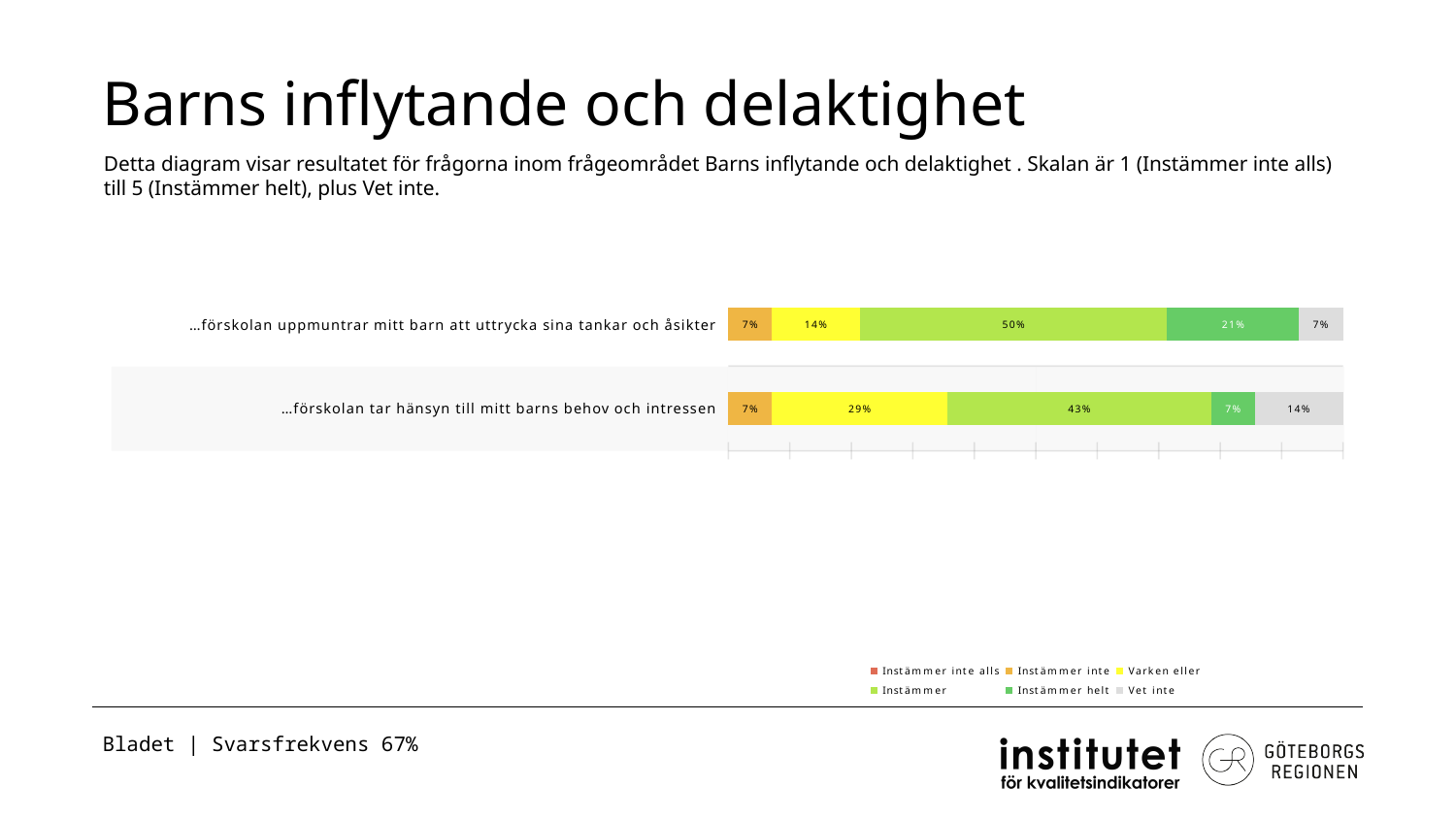
What is the difference between the 'Varken eller' shares of the two statements? 15% What is the 'Instämmer helt' share for '…förskolan uppmuntrar mitt barn att uttrycka sina tankar och åsikter'? 21% Which legend entry is shown in grey? Vet inte What is the 'Vet inte' share for '…förskolan tar hänsyn till mitt barns behov och intressen'? 14% What is the 'Instämmer' share for '…förskolan uppmuntrar mitt barn att uttrycka sina tankar och åsikter'? 50% Which response category has the largest share for '…förskolan tar hänsyn till mitt barns behov och intressen'? Instämmer Which statement has the larger 'Instämmer helt' share? …förskolan uppmuntrar mitt barn att uttrycka sina tankar och åsikter How many series does the legend list? 6 What kind of chart is shown on the slide? Stacked bar chart What is the 'Varken eller' share for '…förskolan tar hänsyn till mitt barns behov och intressen'? 29% How many question statements (categories) are plotted in the chart? 2 What is the difference between the 'Instämmer' shares of the two statements? 7%